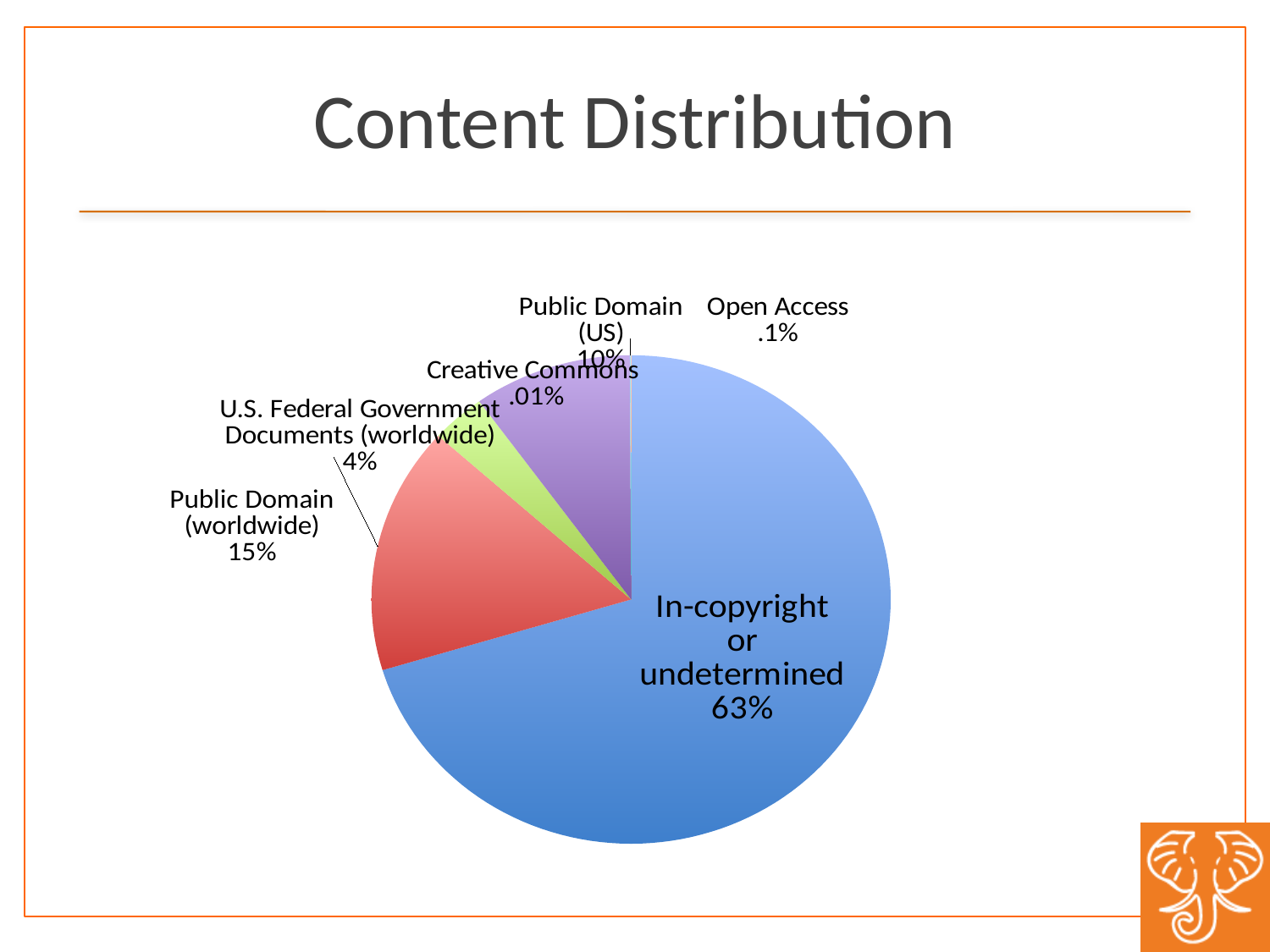
What is the title of the chart? Content Distribution What share of the pie is In-copyright or undetermined? 63% Which category has the largest slice of the pie? In-copyright or undetermined What share of the pie is Open Access? .1% What share of the pie is U.S. Federal Government Documents (worldwide)? 4% What share of the pie is Public Domain (worldwide)? 15% How many categories are shown in the pie chart? 6 Which category has the smallest slice of the pie? Creative Commons Which is larger, the Public Domain (worldwide) slice or the U.S. Federal Government Documents (worldwide) slice? Public Domain (worldwide) What is the difference between the In-copyright or undetermined share and the Public Domain (worldwide) share? 48% What kind of chart is shown on the slide? pie chart What share of the pie is Creative Commons? .01%